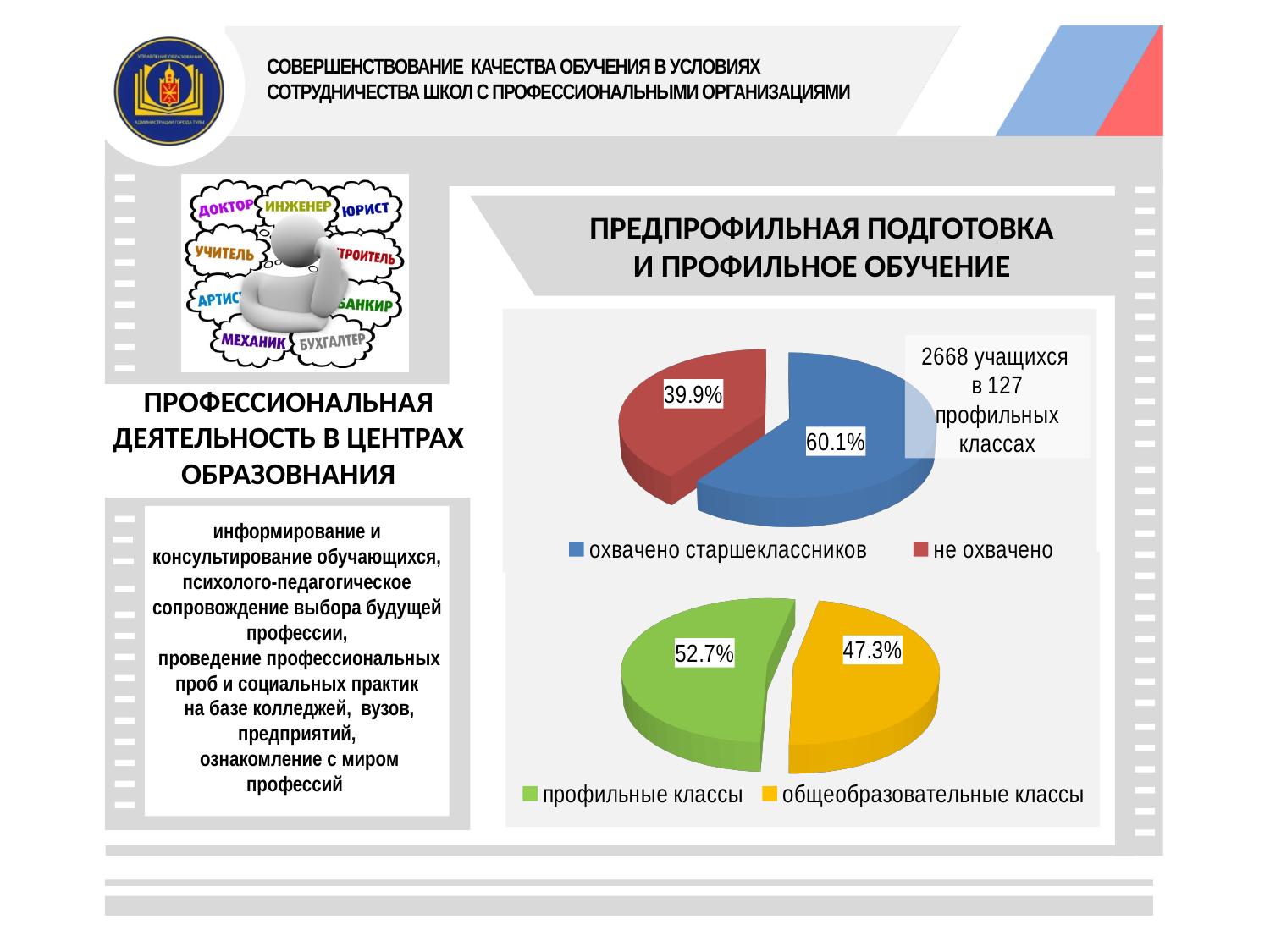
What kind of chart is the top chart on the slide? pie chart In the bottom pie chart, what is the difference between the 'профильные классы' and 'общеобразовательные классы' shares? 5.4% In the top pie chart, which slice is the largest? охвачено старшеклассников In the bottom pie chart, what share is labelled for 'общеобразовательные классы'? 47.3% How many entries does the legend of the top pie chart list? 2 In the top pie chart, what is the difference between the 'охвачено старшеклассников' and 'не охвачено' shares? 20.2% In the top pie chart, what share is labelled for 'не охвачено'? 39.9% In the top pie chart, what colour is the 'не охвачено' slice? red How many slices does the bottom pie chart have? 2 In the top pie chart, what share is labelled for 'охвачено старшеклассников'? 60.1% In the bottom pie chart, what share is labelled for 'профильные классы'? 52.7% In the bottom pie chart, which slice is the smallest? общеобразовательные классы